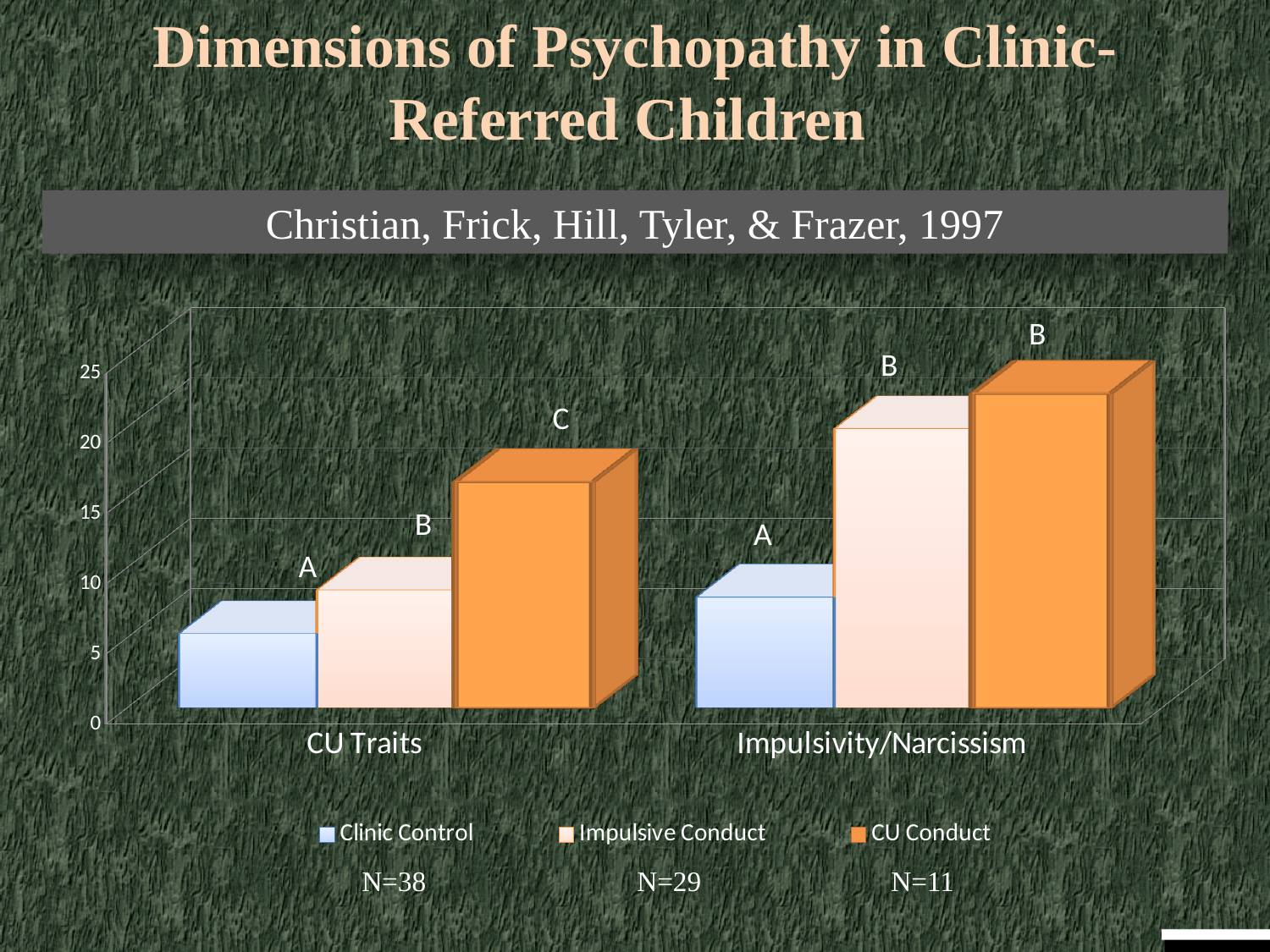
What kind of chart is shown on the slide? bar chart Is the Clinic Control value for CU Traits greater or less than 10? less Which is larger: the CU Conduct value for CU Traits or the Impulsive Conduct value for Impulsivity/Narcissism? Impulsive Conduct value for Impulsivity/Narcissism For Impulsivity/Narcissism, which group has the lowest bar? Clinic Control For CU Traits, which group has the lowest bar? Clinic Control For Impulsivity/Narcissism, which group has the highest bar? CU Conduct Is the CU Conduct value for Impulsivity/Narcissism greater or less than 20? greater How many series does the chart's legend list? 3 Is the CU Conduct value for CU Traits greater or less than 15? greater How many categories are shown on the x axis of the chart? 2 What sample size (N) is shown under the CU Conduct legend entry? N=11 For CU Traits, which group has the highest bar? CU Conduct